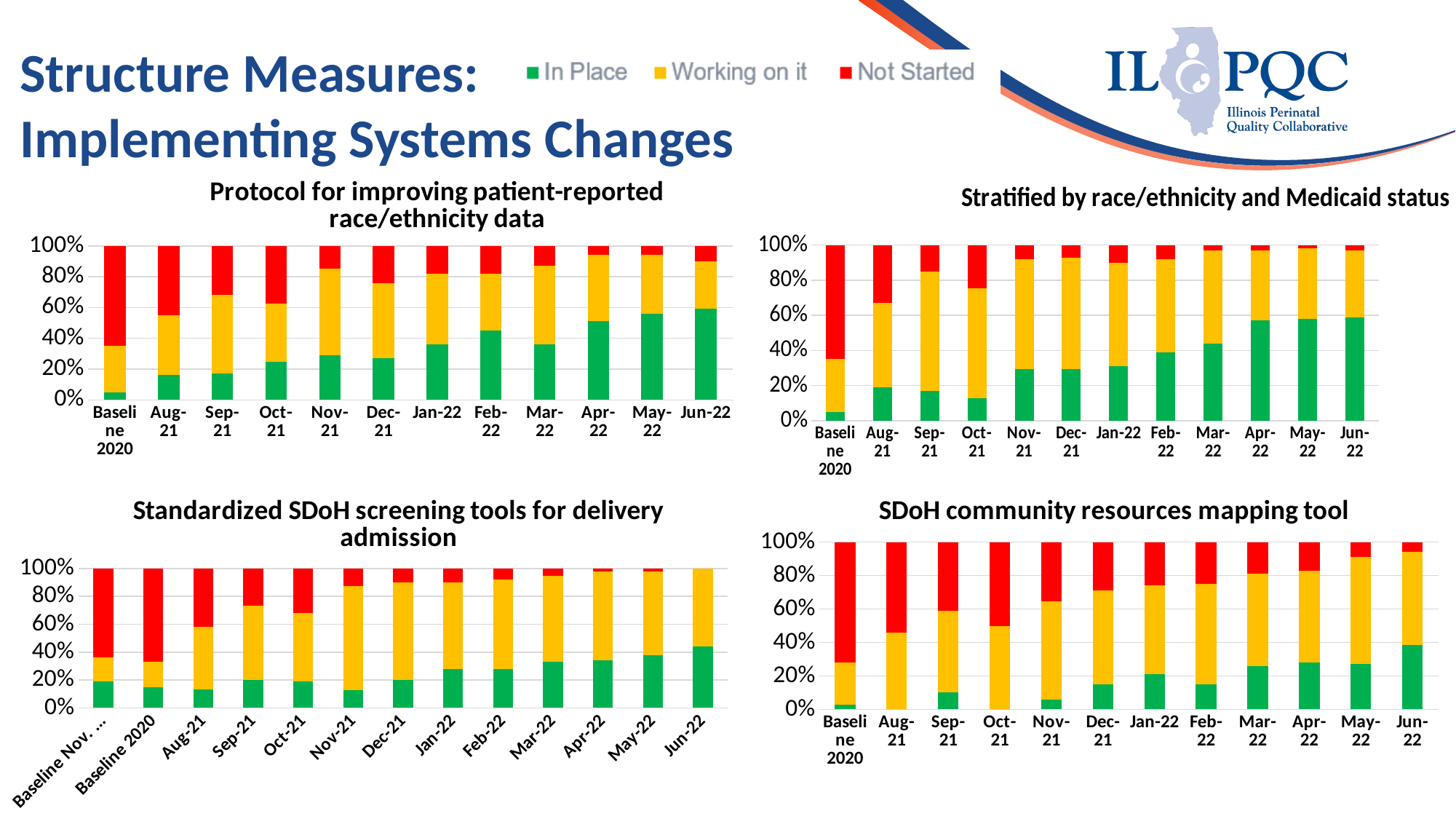
How many series does the legend at the top of the slide list? 3 In the "SDoH community resources mapping tool" chart, which bar has the largest Not Started share? Baseline 2020 In the "Standardized SDoH screening tools for delivery admission" chart, which has the larger In Place share: Baseline 2020 or Jun-22? Jun-22 In the "Protocol for improving patient-reported race/ethnicity data" chart, does the In Place share rise or fall from Baseline 2020 to Jun-22? Rise How many bars are shown in the "Standardized SDoH screening tools for delivery admission" chart? 13 In the "Protocol for improving patient-reported race/ethnicity data" chart, is the In Place share for Jun-22 greater or less than 40%? greater In the "SDoH community resources mapping tool" chart, is the In Place share for Jun-22 greater or less than 20%? greater How many bars are shown in the "SDoH community resources mapping tool" chart? 12 In the "Stratified by race/ethnicity and Medicaid status" chart, is the In Place share for Baseline 2020 greater or less than 20%? less Which colour represents the "Not Started" series in the legend? Red What are the three series named in the legend? In Place, Working on it, Not Started What kind of chart is "Protocol for improving patient-reported race/ethnicity data"? Stacked bar chart